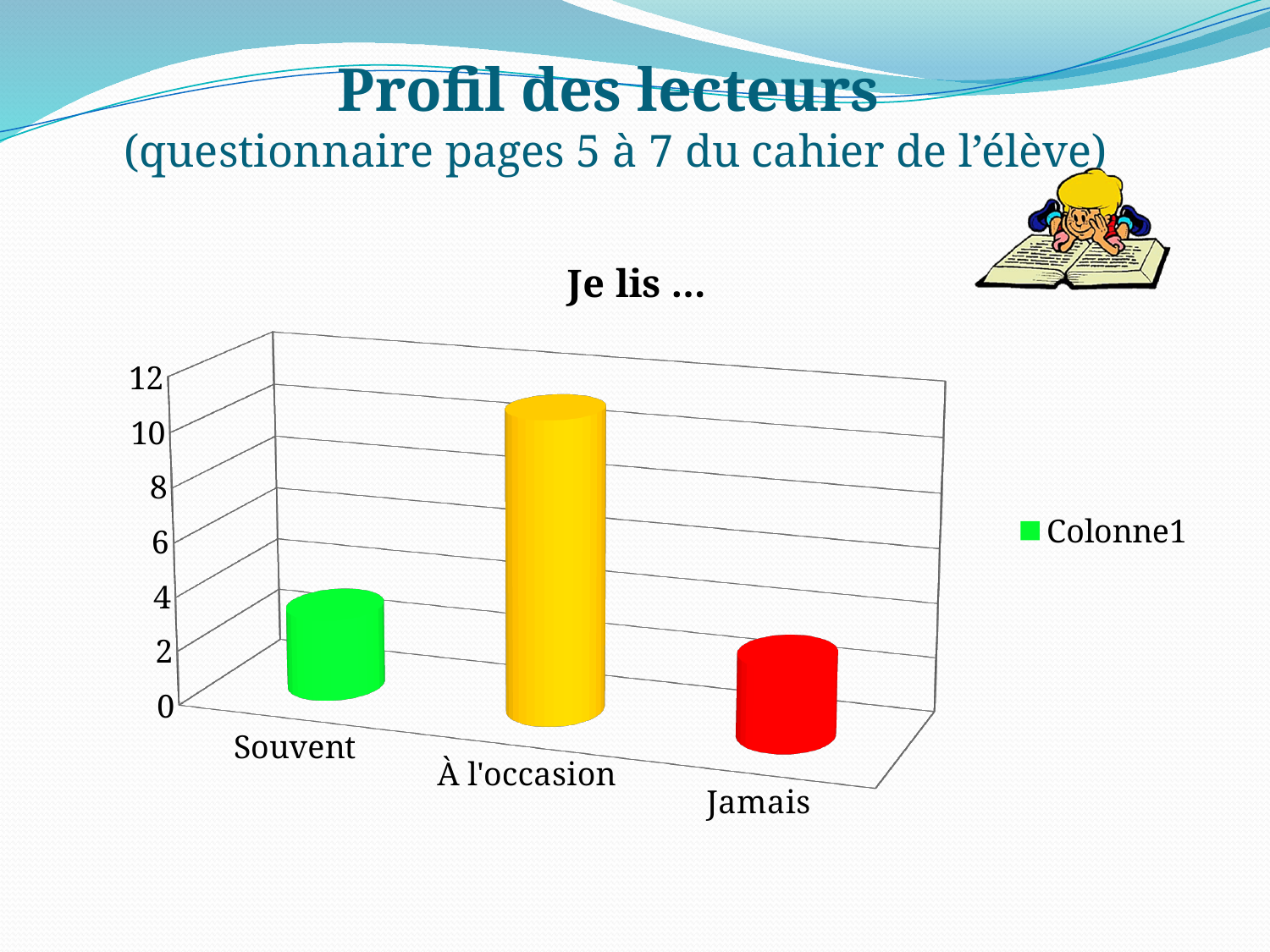
How many categories are shown on the x axis of the chart? 3 Is the value for À l'occasion greater or less than 8? greater Is the value for Souvent greater or less than 8? less Which is larger, the value for À l'occasion or the value for Jamais? À l'occasion Which category has the highest value? À l'occasion Which is larger, the value for À l'occasion or the value for Souvent? À l'occasion What kind of chart is shown on the slide? bar chart How many series does the chart legend list? 1 Is the value for Jamais greater or less than 6? less What is the highest value shown on the vertical axis? 12 What is the title of the chart? Je lis … What is the name of the series listed in the legend? Colonne1